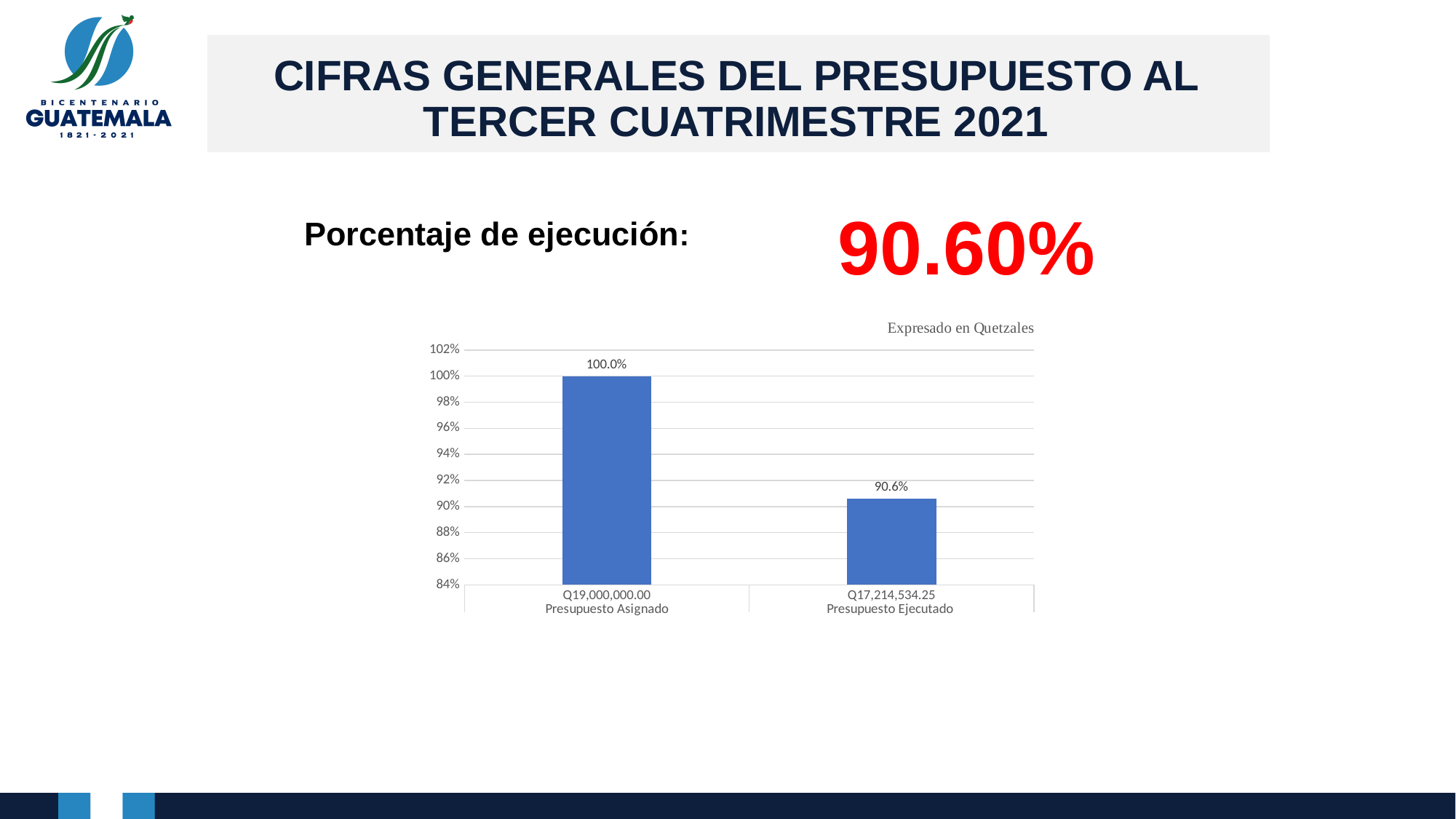
Which is larger, the value for Presupuesto Asignado or Presupuesto Ejecutado? Presupuesto Asignado What is the value shown for Presupuesto Ejecutado? 90.6% Do the values rise or fall from left to right across the chart? fall Is the value for Presupuesto Ejecutado greater or less than 92%? less What amount in quetzales is shown under the Presupuesto Asignado bar? Q19,000,000.00 How many bars are plotted in the chart? 2 Which category has the highest value? Presupuesto Asignado What is the difference between the values for Presupuesto Asignado and Presupuesto Ejecutado? 9.4% What amount in quetzales is shown under the Presupuesto Ejecutado bar? Q17,214,534.25 What kind of chart is shown on the slide? bar chart Which category has the lowest value? Presupuesto Ejecutado What is the value shown for Presupuesto Asignado? 100.0%